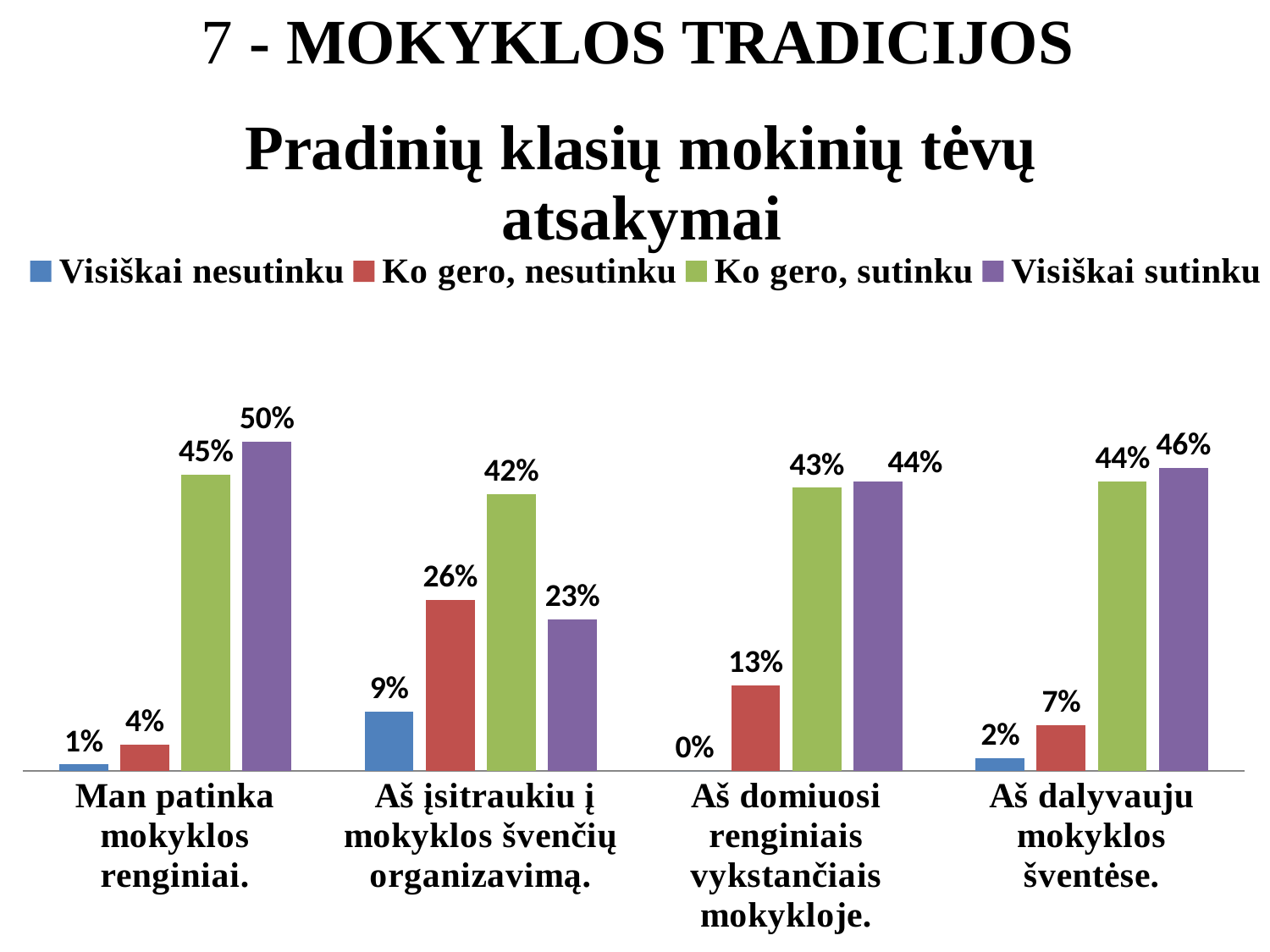
Which category has the highest value for "Visiškai sutinku"? Man patinka mokyklos renginiai. How many series does the legend list? 4 What kind of chart is shown on the slide? Bar chart What is the value for "Visiškai nesutinku" in the category "Aš domiuosi renginiais vykstančiais mokykloje."? 0% Which category has the lowest value for "Visiškai sutinku"? Aš įsitraukiu į mokyklos švenčių organizavimą. In the category "Aš domiuosi renginiais vykstančiais mokykloje.", which is larger: "Ko gero, sutinku" or "Visiškai sutinku"? Visiškai sutinku What is the difference between "Ko gero, sutinku" and "Ko gero, nesutinku" in the category "Aš įsitraukiu į mokyklos švenčių organizavimą."? 16% What is the value for "Ko gero, sutinku" in the category "Aš dalyvauju mokyklos šventėse."? 44% What is the value for "Visiškai sutinku" in the category "Man patinka mokyklos renginiai."? 50% What is the value for "Ko gero, nesutinku" in the category "Aš įsitraukiu į mokyklos švenčių organizavimą."? 26% How many categories are shown on the x axis? 4 What colour represents the series "Ko gero, sutinku"? Green